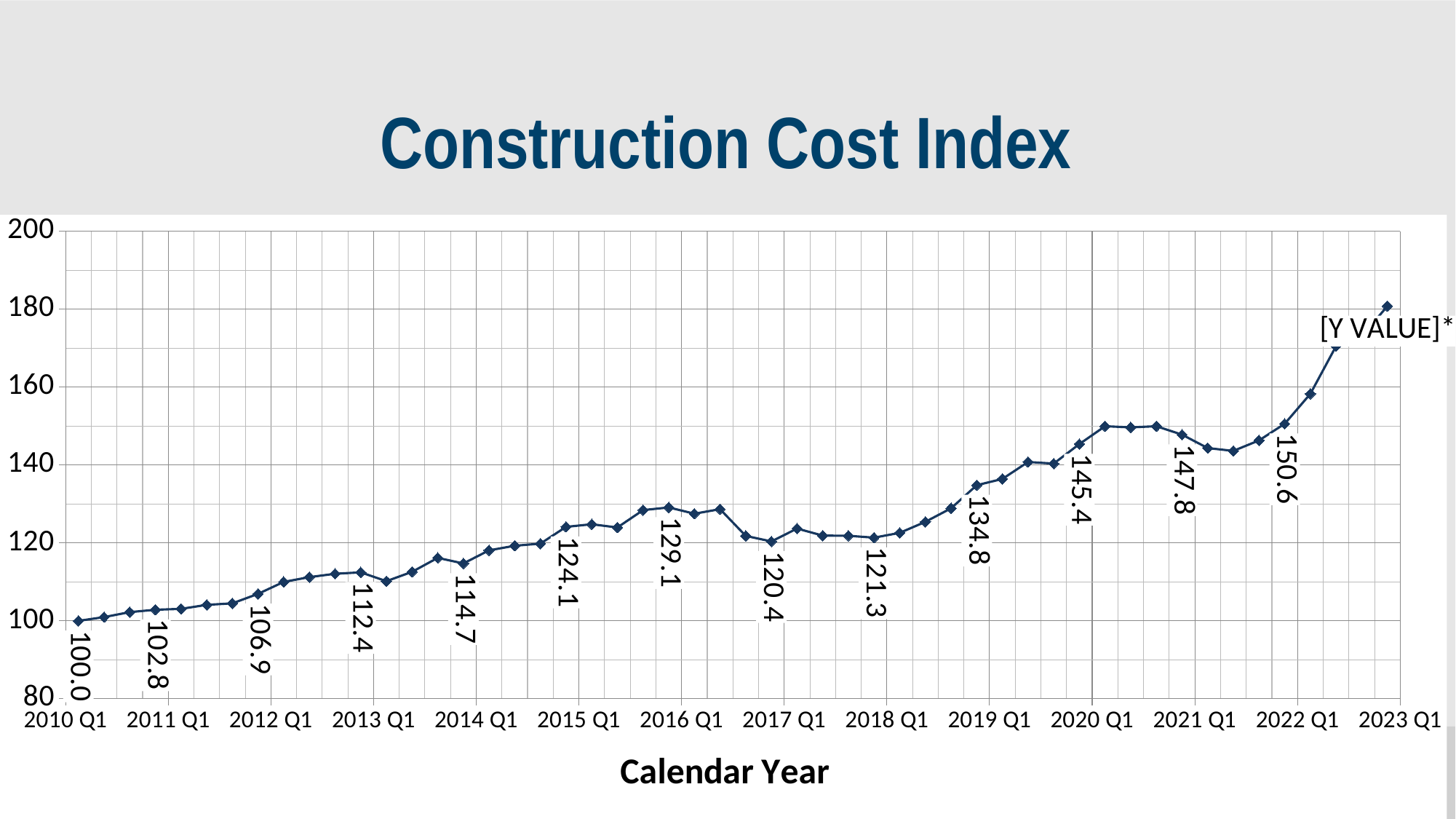
What is the Construction Cost Index value labeled at 2019 Q1? 134.8 What is the difference between the labeled values at 2016 Q1 and 2017 Q1? 8.7 Which has the higher labeled value, 2016 Q1 or 2017 Q1? 2016 Q1 At which x-axis point is the Construction Cost Index lowest? 2010 Q1 What is the Construction Cost Index value labeled at 2022 Q1? 150.6 What is the Construction Cost Index value labeled at 2010 Q1? 100.0 What kind of chart is shown on the slide? line chart What is the Construction Cost Index value labeled at 2015 Q1? 124.1 What is the title of the x axis? Calendar Year Does the Construction Cost Index generally rise or fall from 2010 Q1 to 2023 Q1? rise Is the value plotted at 2023 Q1 greater or less than 160? greater By how much did the labeled Construction Cost Index value increase from 2010 Q1 to 2022 Q1? 50.6